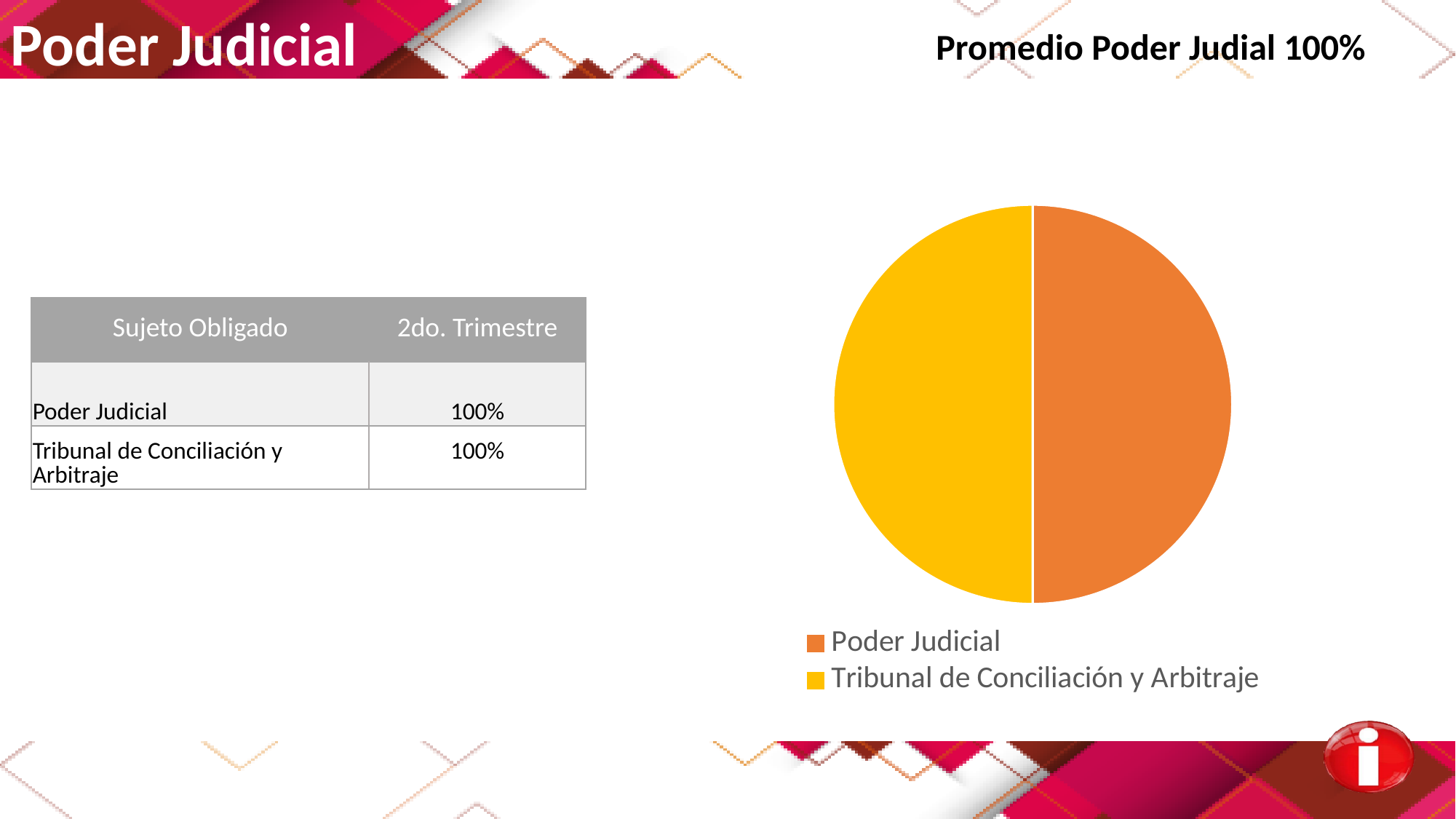
How many slices does the pie chart have? 2 What value does the table give for Poder Judicial in the 2do. Trimestre? 100% What share of the pie does the Poder Judicial slice take up? 50% Which colour represents Tribunal de Conciliación y Arbitraje in the pie chart? yellow What is the difference between the 2do. Trimestre values for Poder Judicial and Tribunal de Conciliación y Arbitraje? 0% How many entries does the legend of the pie chart list? 2 Which colour represents Poder Judicial in the pie chart? orange What value does the table give for Tribunal de Conciliación y Arbitraje in the 2do. Trimestre? 100% What kind of chart is shown on the slide? pie chart What is the Promedio Poder Judial stated at the top right of the slide? 100% What share of the pie does the Tribunal de Conciliación y Arbitraje slice take up? 50%